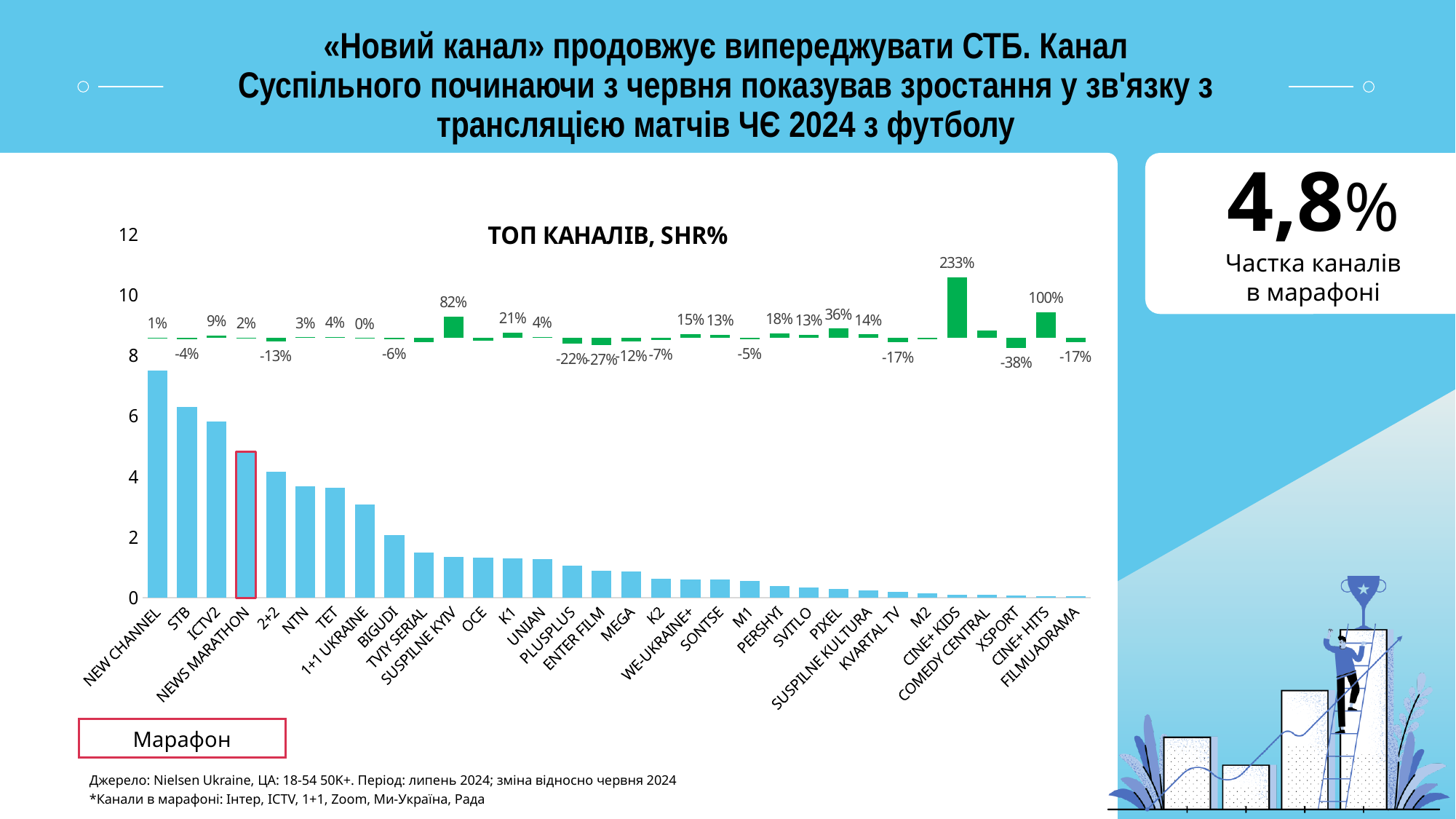
Which channel has the highest share (tallest blue bar) in the chart? NEW CHANNEL What percentage change is labelled for SUSPILNE KYIV? 82% Which channel has the lowest labelled percentage change? XSPORT What kind of chart is shown on the slide? bar chart Which has the larger labelled percentage change, PERSHYI or PIXEL? PIXEL How many channels are shown along the x axis of the chart? 32 What is the title of the chart? ТОП КАНАЛІВ, SHR% Is the share value for NEW CHANNEL greater or less than 6? greater Which channel has the largest labelled percentage change? CINE+ KIDS Do the blue share bars rise or fall from left to right along the x axis? fall Is the share value for 1+1 UKRAINE greater or less than 2? greater Is the share value for BIGUDI greater or less than 4? less